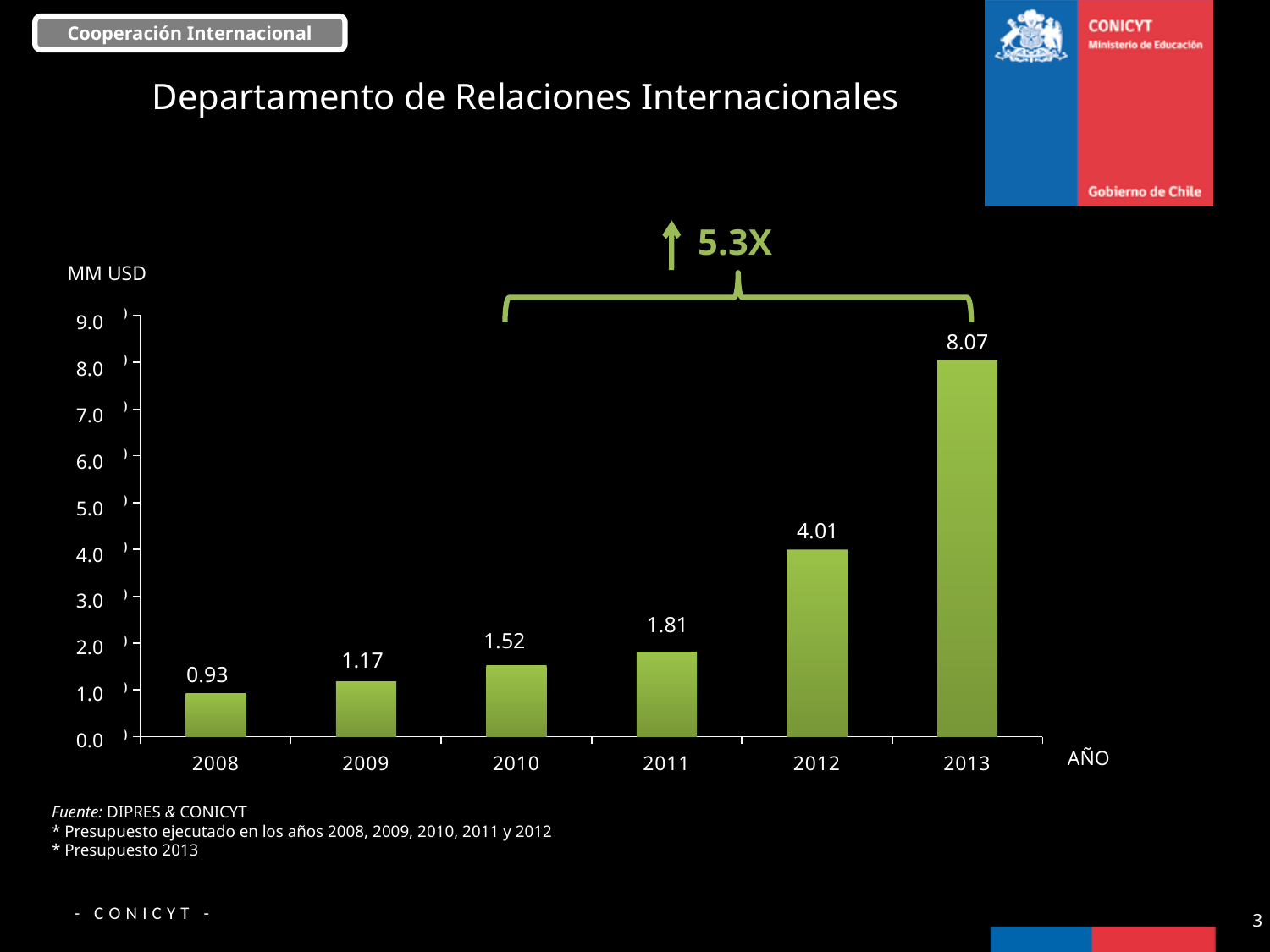
What is the value for 2008? 0.93 How many years are shown on the x axis? 6 What is the difference between the values for 2013 and 2012? 4.06 Which is larger, the value for 2012 or the value for 2011? 2012 Is the value for 2012 greater or less than 3.0? greater Which year has the highest value? 2013 What is the difference between the values for 2010 and 2009? 0.35 Do the values rise or fall from 2008 to 2013? rise What kind of chart is shown on the slide? bar chart What is the value for 2013? 8.07 Which year has the lowest value? 2008 What is the value for 2011? 1.81